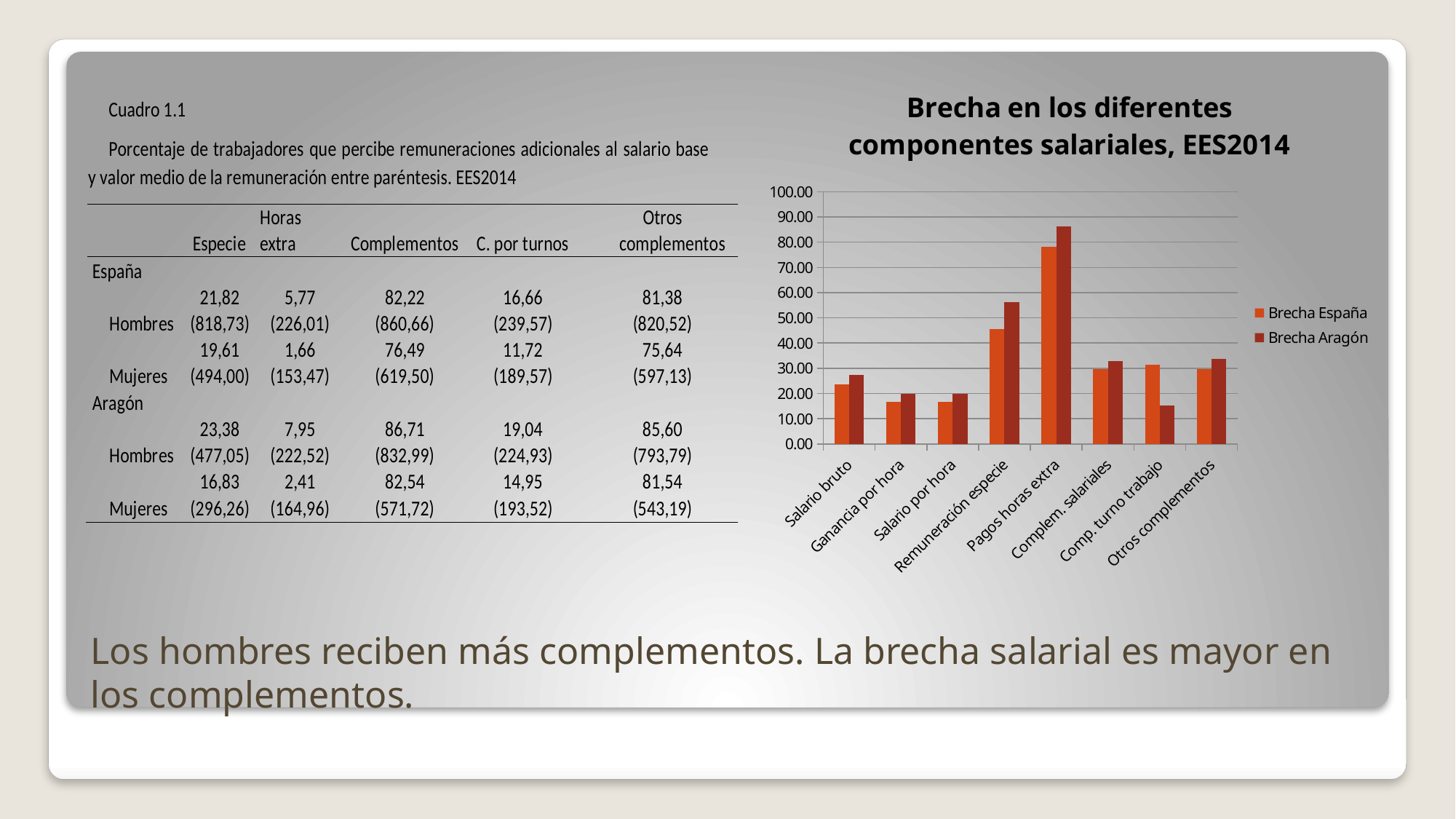
What are the two series named in the chart legend? Brecha España and Brecha Aragón Which category has the highest value for Brecha Aragón? Pagos horas extra Which category has the highest value for Brecha España? Pagos horas extra How many categories are shown on the x axis of the chart? 8 Which category has the lowest value for Brecha Aragón? Comp. turno trabajo Is the value for Brecha Aragón in Pagos horas extra greater or less than 80? greater How many series does the chart legend list? 2 What is the title of the chart? Brecha en los diferentes componentes salariales, EES2014 Is the value for Brecha España in Remuneración especie greater or less than 50? less For Comp. turno trabajo, which series has the larger value, Brecha España or Brecha Aragón? Brecha España For Pagos horas extra, which series has the larger value, Brecha España or Brecha Aragón? Brecha Aragón What kind of chart is shown on the slide? bar chart